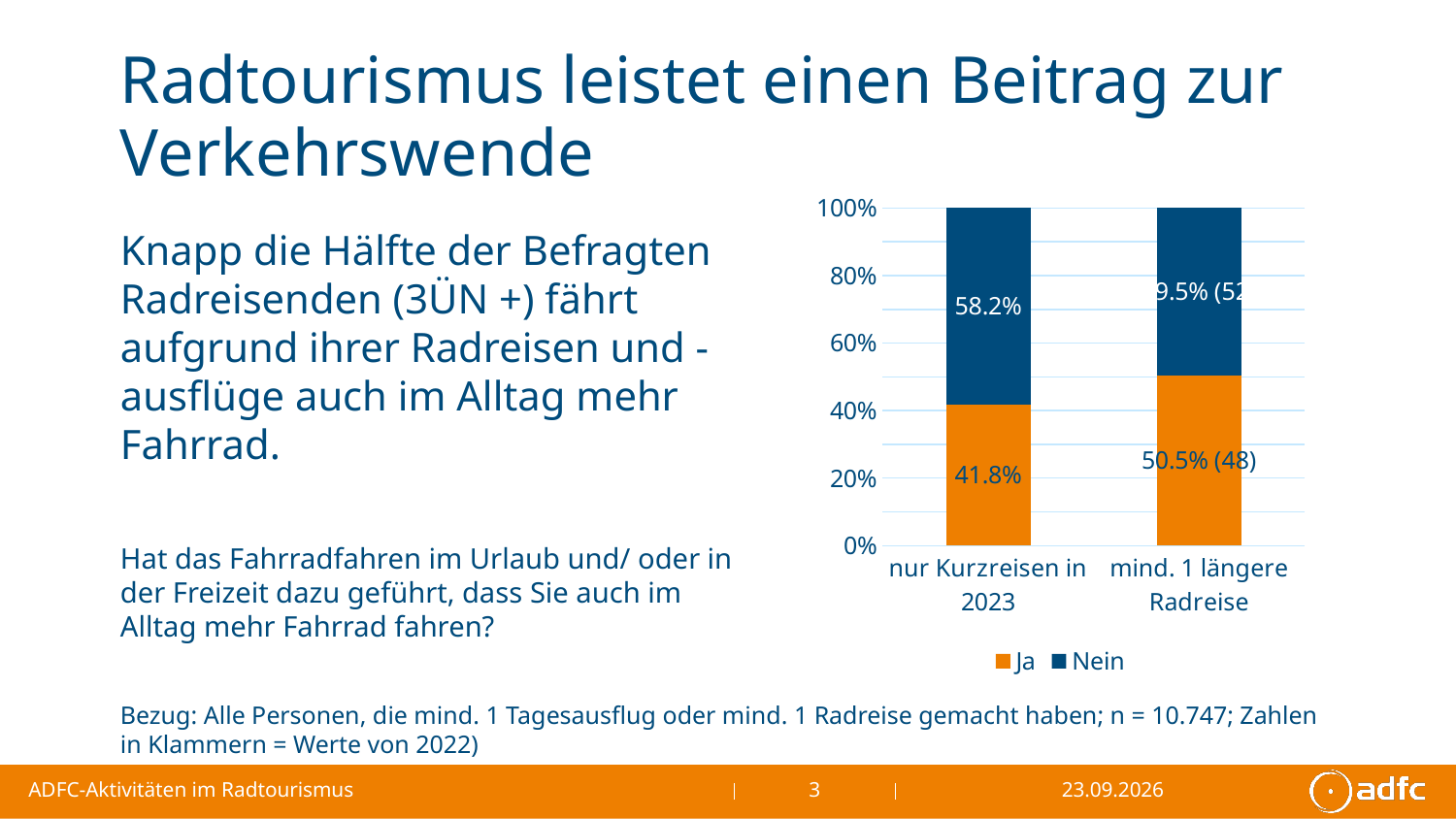
In the "nur Kurzreisen in 2023" bar, which is larger, "Ja" or "Nein"? Nein What is the value for "Ja" in the "mind. 1 längere Radreise" bar? 50.5% (48) What is the value for "Ja" in the "nur Kurzreisen in 2023" bar? 41.8% What are the two entries in the chart legend? Ja, Nein In which category is the "Ja" share larger? mind. 1 längere Radreise What kind of chart is shown on the slide? stacked bar chart How many categories are shown on the x axis of the chart? 2 What is the value for "Nein" in the "nur Kurzreisen in 2023" bar? 58.2% How many series does the chart legend list? 2 Is the "Nein" value for "mind. 1 längere Radreise" greater or less than 60%? less What is the difference between "Nein" and "Ja" in the "nur Kurzreisen in 2023" bar? 16.4% By how much does the "Ja" share for "mind. 1 längere Radreise" exceed the "Ja" share for "nur Kurzreisen in 2023"? 8.7%